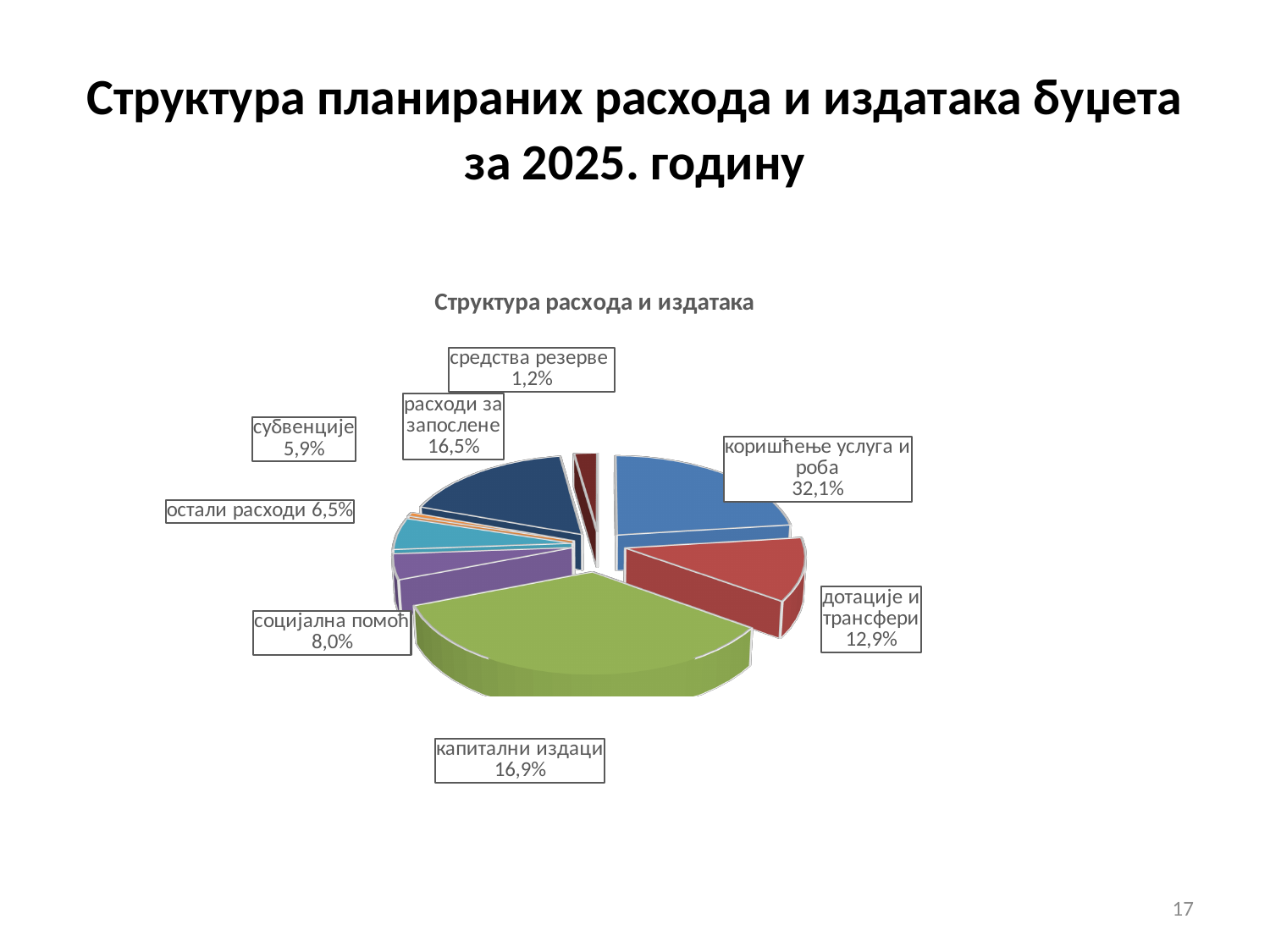
What kind of chart is shown on the slide? pie chart What share of the pie is капитални издаци? 16,9% Which is larger, the share for капитални издаци or the share for расходи за запослене? капитални издаци What is the difference in percentage points between коришћење услуга и роба and дотације и трансфери? 19,2 What share of the pie is дотације и трансфери? 12,9% How many categories (slices) does the pie chart have? 8 What share of the pie is средства резерве? 1,2% What share of the pie is социјална помоћ? 8,0% What is the title of the chart? Структура расхода и издатака What share of the pie is коришћење услуга и роба? 32,1% Which category has the smallest share of the pie? средства резерве Which category has the largest share of the pie? коришћење услуга и роба